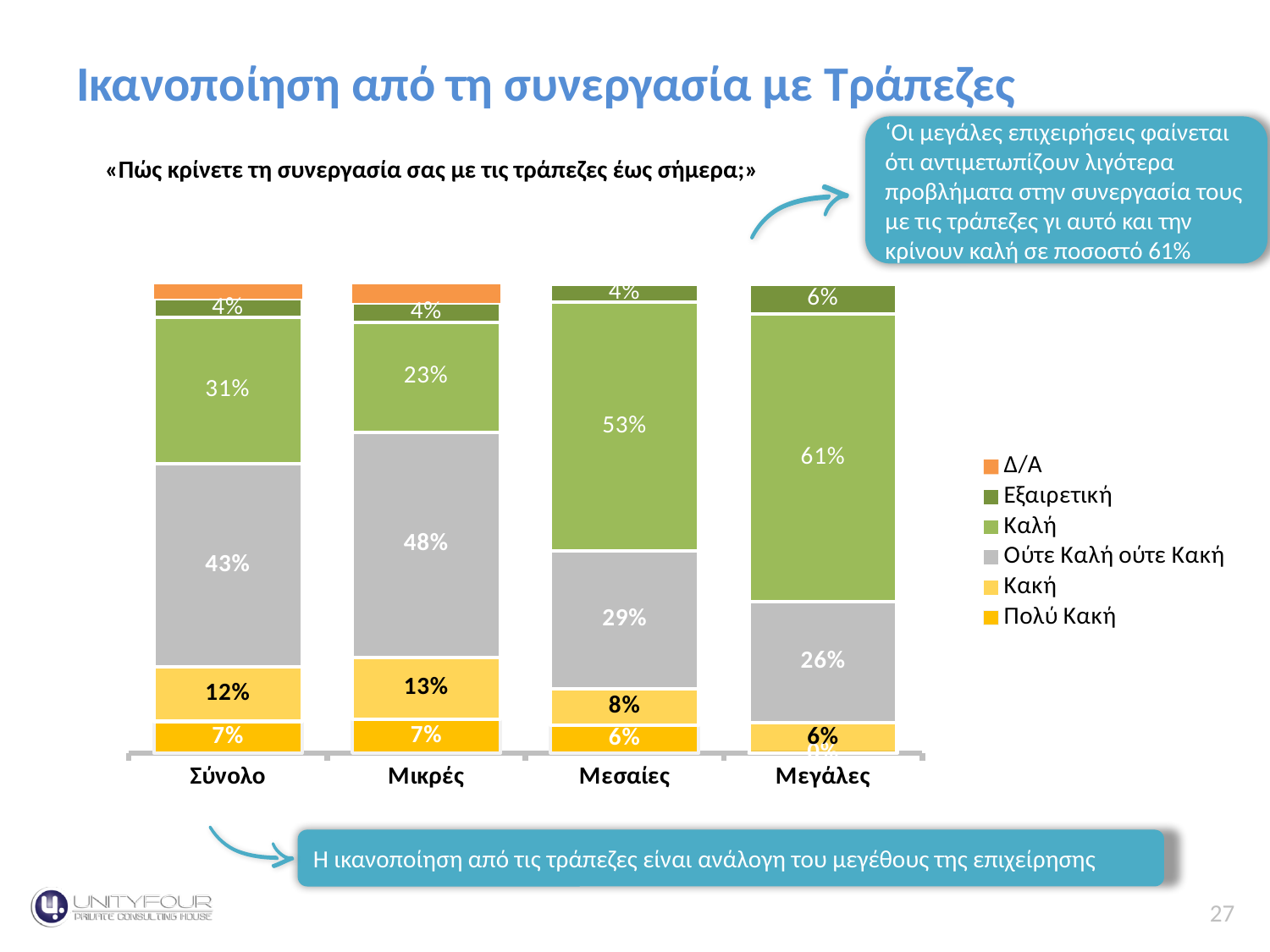
What type of chart is shown on the slide? stacked bar chart Which legend entry is shown in orange? Δ/Α Which category has the highest value for Καλή? Μεγάλες What is the value of Κακή for Σύνολο? 12% What is the value of Ούτε Καλή ούτε Κακή for Μικρές? 48% Which is larger, the Κακή value for Μικρές or for Μεσαίες? Μικρές How many categories are shown on the x axis of the chart? 4 What is the value of Πολύ Κακή for Μεσαίες? 6% What is the value of Καλή for Μεγάλες? 61% What is the difference between the Καλή values for Μεσαίες and Μικρές? 30% Which category has the lowest value for Ούτε Καλή ούτε Κακή? Μεγάλες How many series does the legend list? 6